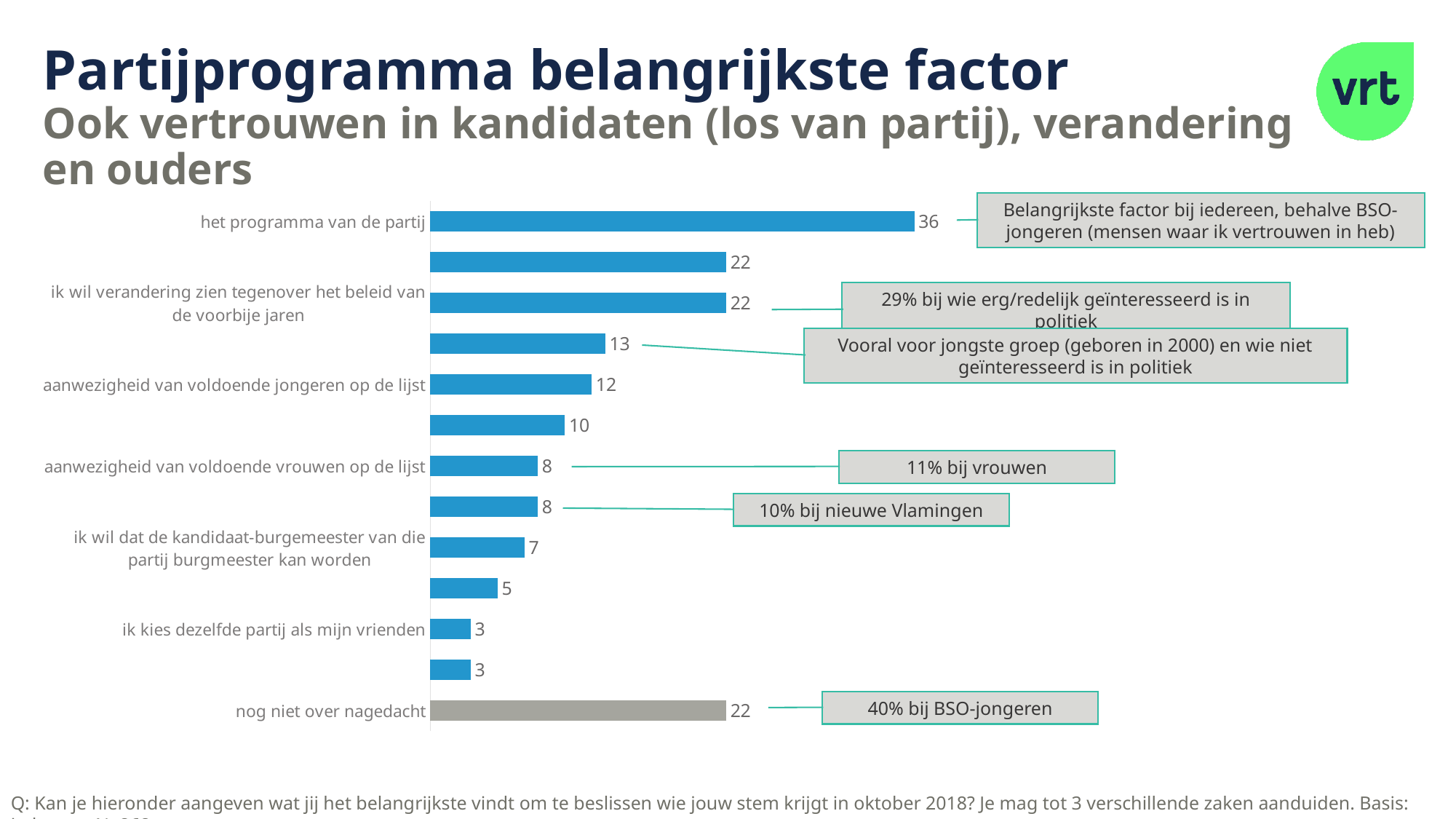
What is the lowest value shown on any bar in the chart? 3 What value is shown for 'aanwezigheid van voldoende jongeren op de lijst'? 12 Which is larger: the value for 'aanwezigheid van voldoende jongeren op de lijst' or for 'aanwezigheid van voldoende vrouwen op de lijst'? aanwezigheid van voldoende jongeren op de lijst What is the difference between the values for 'het programma van de partij' and 'nog niet over nagedacht'? 14 How many bars are plotted in the chart? 13 What value is shown for 'ik wil dat de kandidaat-burgemeester van die partij burgmeester kan worden'? 7 What value is shown for 'nog niet over nagedacht'? 22 What kind of chart is shown on the slide? bar chart What value is shown for 'aanwezigheid van voldoende vrouwen op de lijst'? 8 Which category has the highest value in the chart? het programma van de partij What value is shown for 'ik kies dezelfde partij als mijn vrienden'? 3 What value is shown for 'het programma van de partij'? 36